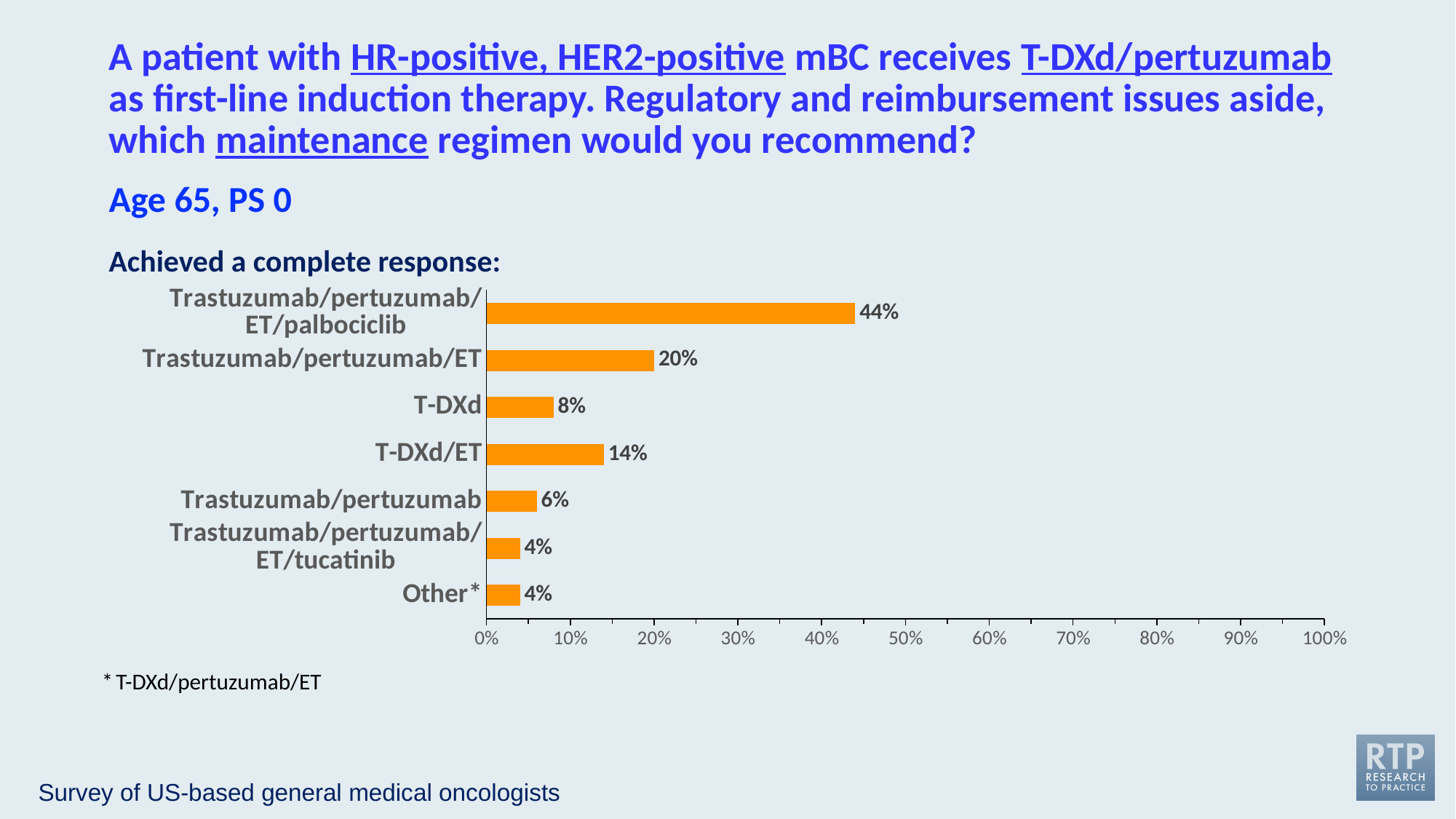
Is the value for Trastuzumab/pertuzumab/ET/palbociclib greater or less than 40%? greater What is the combined percentage for Trastuzumab/pertuzumab/ET/tucatinib and Other*? 8% What type of chart is used on this slide? Bar chart How many maintenance regimen categories are shown in the chart? 7 What is the difference in percentage points between Trastuzumab/pertuzumab/ET/palbociclib and Trastuzumab/pertuzumab/ET? 24 percentage points What percentage of respondents recommended T-DXd/ET? 14% What percentage of respondents recommended Trastuzumab/pertuzumab/ET/palbociclib as maintenance? 44% What percentage of respondents recommended T-DXd alone? 8% Which received a larger share of recommendations, T-DXd or T-DXd/ET? T-DXd/ET What percentage of respondents recommended Trastuzumab/pertuzumab/ET? 20% Which maintenance regimen received the highest percentage of recommendations? Trastuzumab/pertuzumab/ET/palbociclib According to the footnote, what does the Other* category refer to? T-DXd/pertuzumab/ET